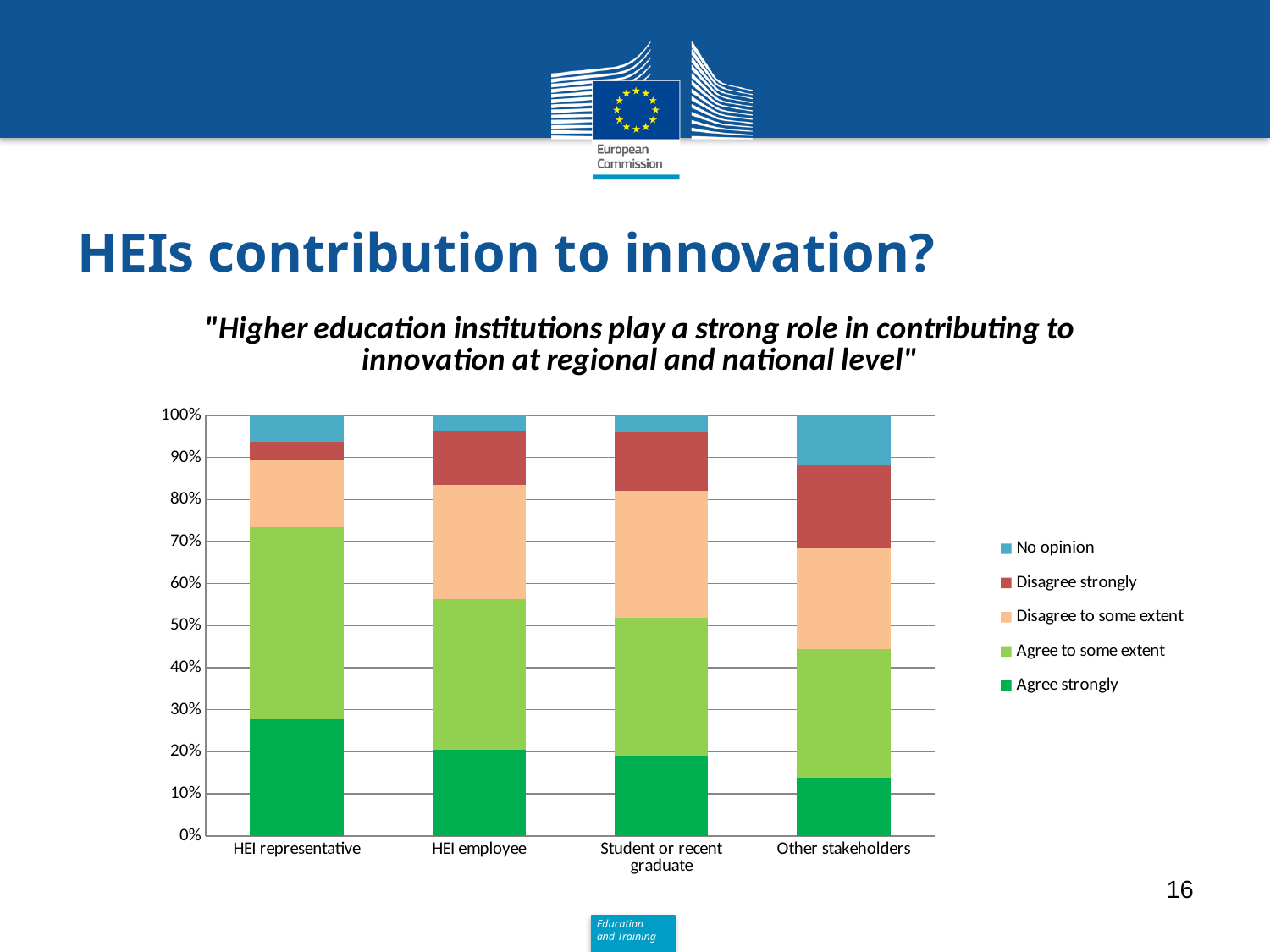
What kind of chart is shown on the slide? Stacked bar chart Which legend entry is listed first (at the top) in the chart's legend? No opinion Which respondent category has the largest 'Agree strongly' segment? HEI representative How many respondent categories are shown on the x axis of the chart? 4 Does the 'Agree strongly' segment rise or fall moving from left to right across the categories? fall Is the 'Agree strongly' share for Other stakeholders greater or less than 20%? less Which respondent category has the largest 'No opinion' segment? Other stakeholders Is the combined share of 'Agree strongly' and 'Agree to some extent' for HEI representative greater or less than 70%? greater Which has the larger 'No opinion' segment: HEI representative or Other stakeholders? Other stakeholders How many series does the chart's legend list? 5 Is the 'Agree strongly' share for HEI representative greater or less than 20%? greater Which respondent category has the smallest 'Agree strongly' segment? Other stakeholders